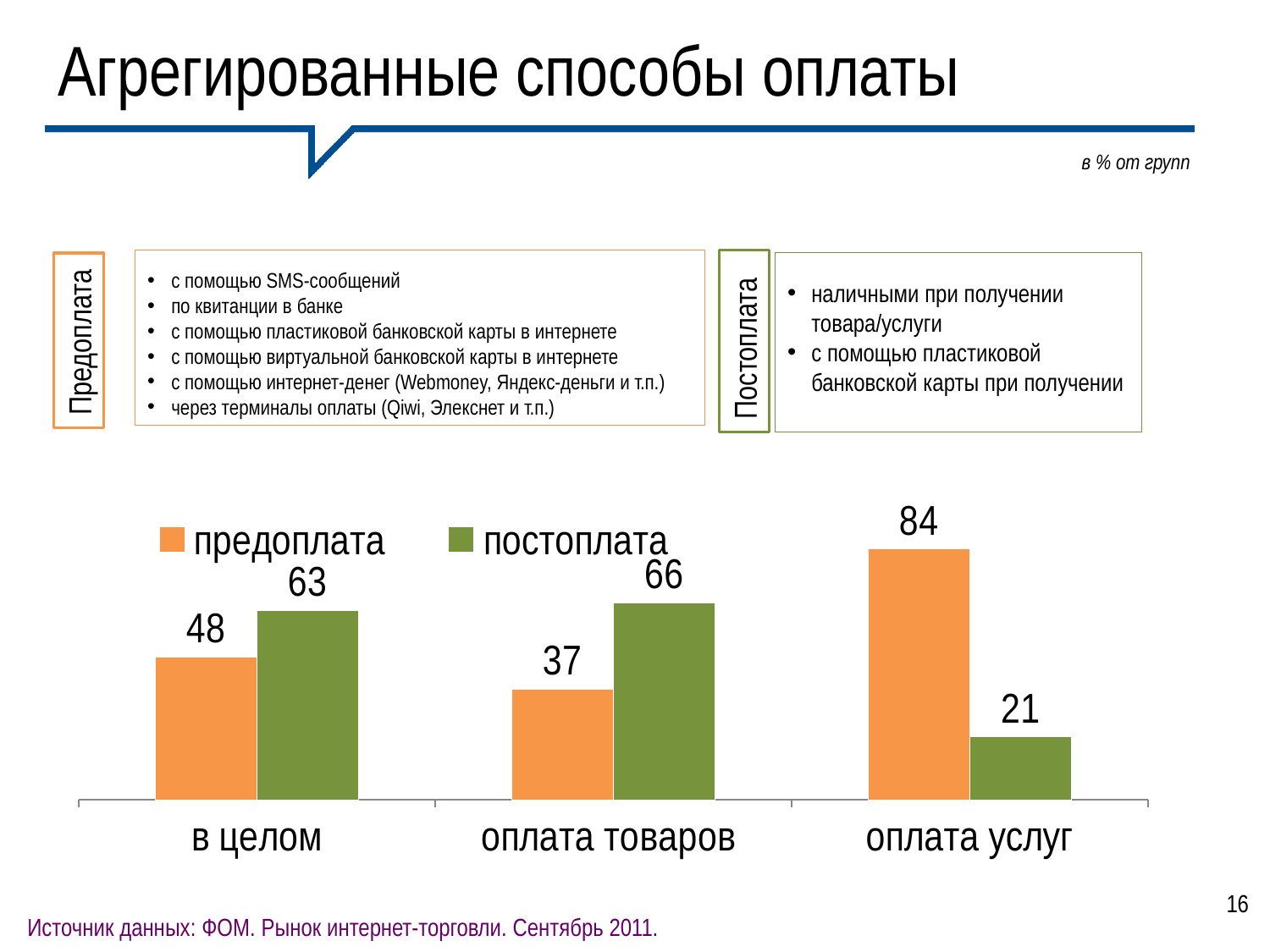
Which category has the highest value for предоплата? оплата услуг What kind of chart is shown on the slide? bar chart What is the value for постоплата in the оплата товаров category? 66 How many series does the legend list? 2 What is the value for предоплата in the в целом category? 48 Which category has the lowest value for постоплата? оплата услуг What is the difference between постоплата and предоплата in the в целом category? 15 What is the value for постоплата in the оплата услуг category? 21 How many categories are shown on the x axis? 3 In the оплата товаров category, which is larger: предоплата or постоплата? постоплата What is the value for предоплата in the оплата услуг category? 84 What is the difference between предоплата and постоплата in the оплата услуг category? 63